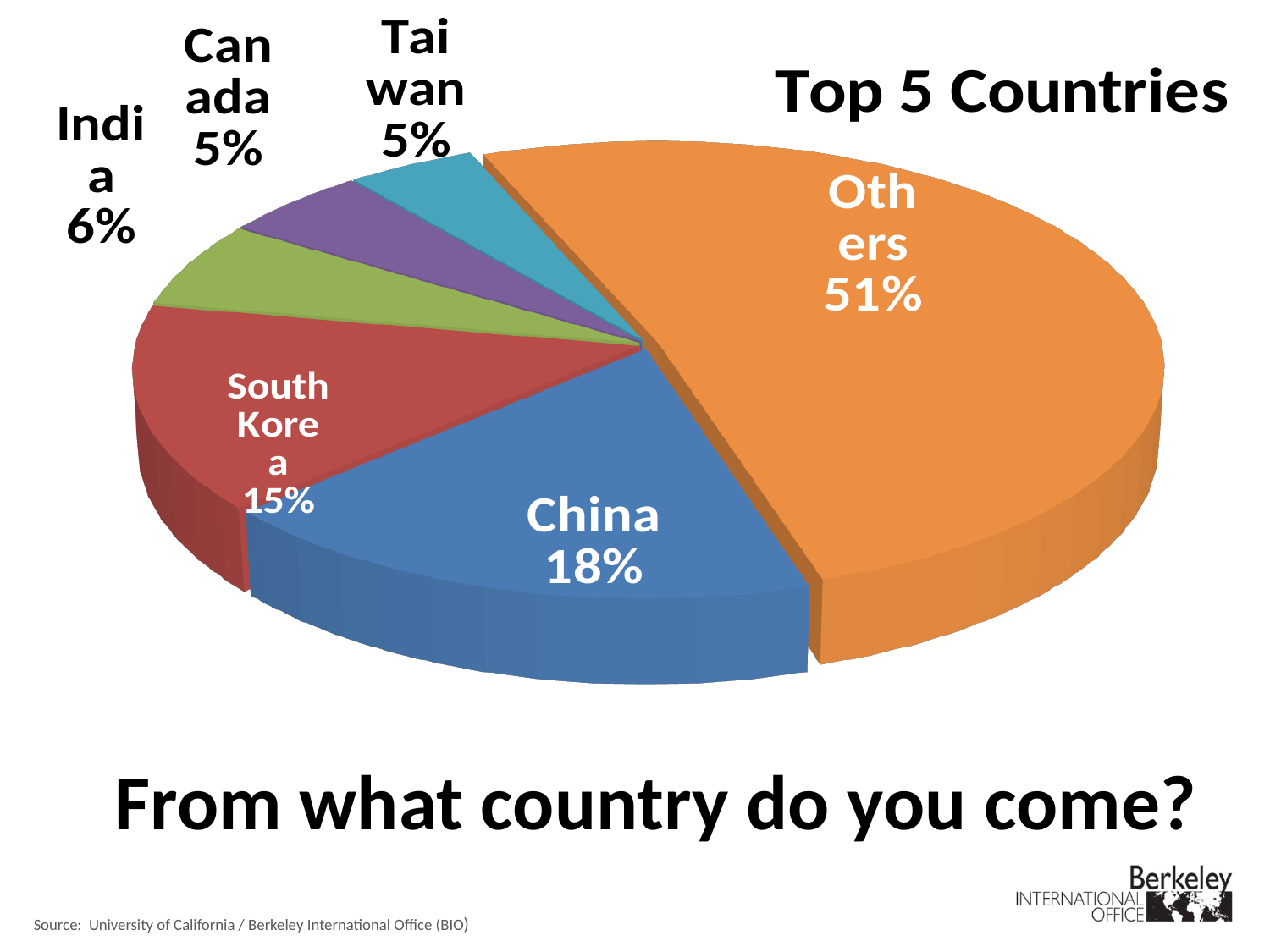
What percentage of the pie does China account for? 18% Which is larger, the share for India or the share for Canada? India What is the difference in percentage points between China and South Korea? 3 What colour is the China slice? Blue Which slice of the pie is the largest? Others What is the title of the chart? Top 5 Countries What percentage of the pie does Others account for? 51% What kind of chart is shown on the slide? Pie chart What percentage of the pie does India account for? 6% Which of the five named countries has the largest share? China What percentage of the pie does South Korea account for? 15% How many slices does the pie chart have? 6